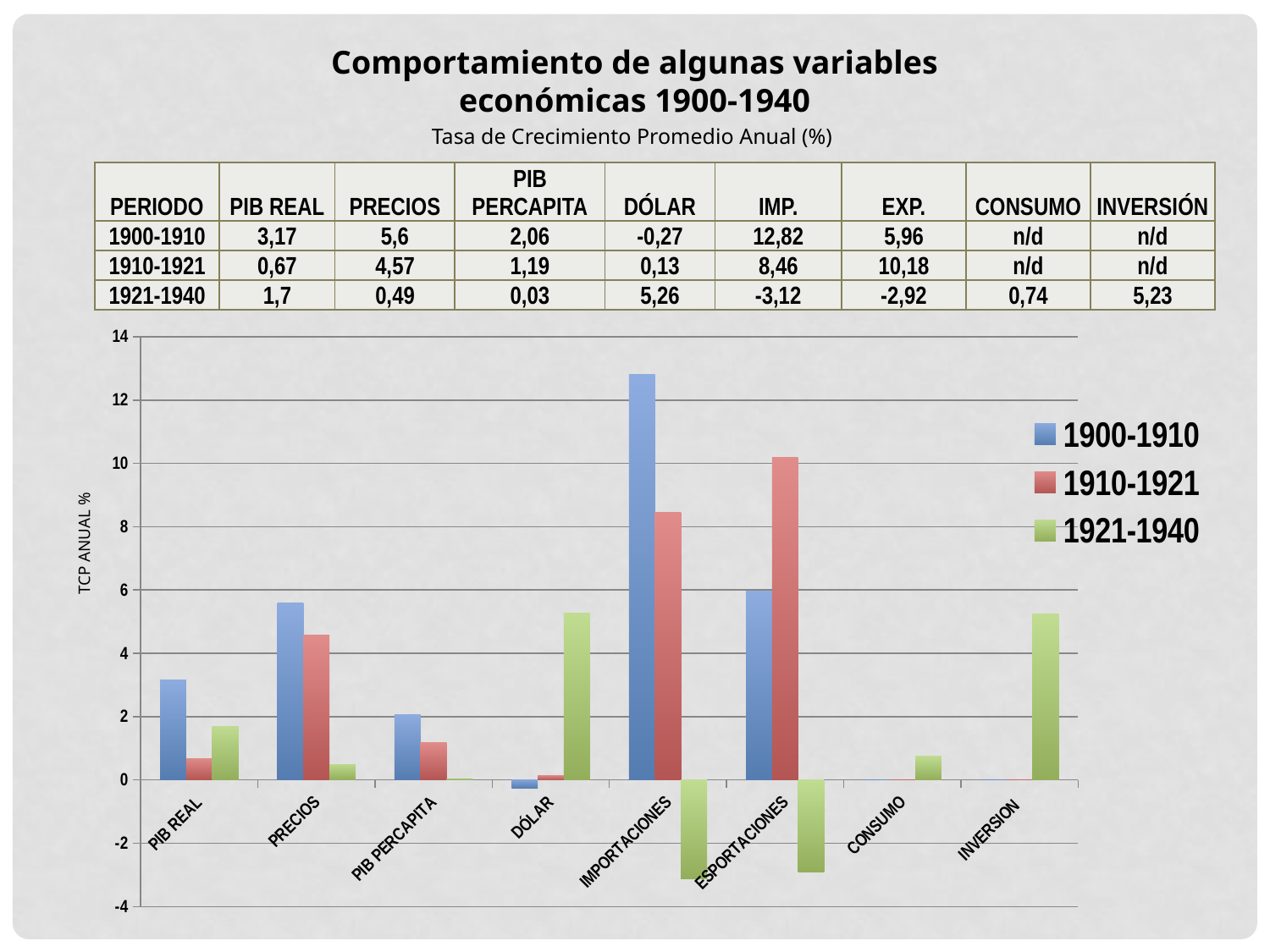
Using the table values, what is the difference between PRECIOS in 1900-1910 (5,6) and PRECIOS in 1921-1940 (0,49)? 5,11 What kind of chart is shown on the slide? bar chart Which is larger for PRECIOS: the 1900-1910 value or the 1910-1921 value? 1900-1910 Which category has the highest bar for the 1900-1910 series? IMPORTACIONES What is the label of the vertical axis of the chart? TCP ANUAL % How many series does the chart legend list? 3 According to the table, what is the value for EXP. in the period 1910-1921? 10,18 Is the value for IMPORTACIONES in 1900-1910 greater or less than 12? greater How many categories are shown along the x axis of the chart? 8 According to the table, what is the value for IMP. in the period 1900-1910? 12,82 According to the table, what is the value for INVERSIÓN in the period 1921-1940? 5,23 Which category has the lowest bar for the 1921-1940 series? IMPORTACIONES